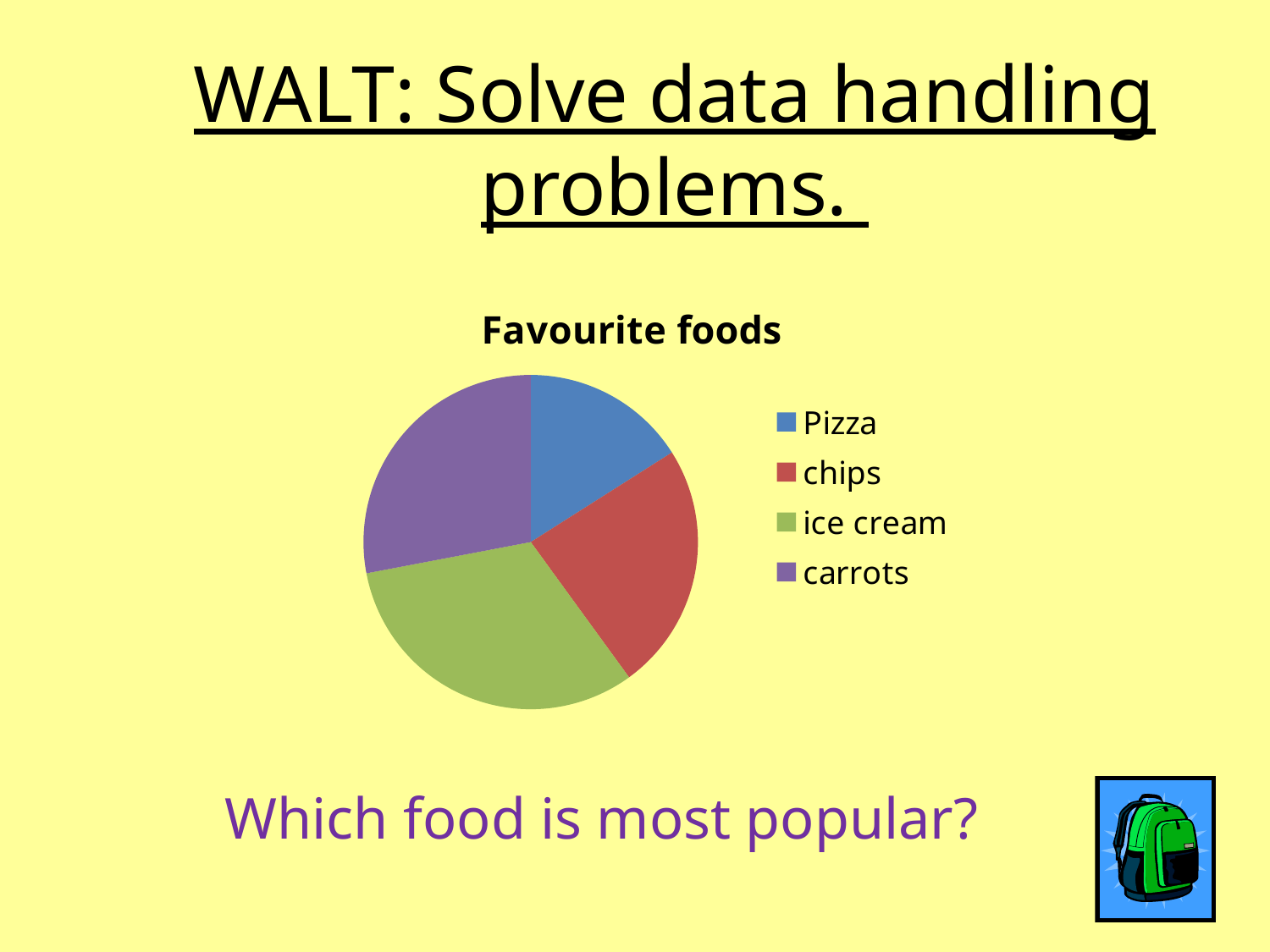
How many entries does the legend list? 4 What colour is the ice cream slice? green What kind of chart is shown on the slide? pie chart Which slice is larger, Pizza or ice cream? ice cream How many categories does the pie chart show? 4 Which food has the largest slice of the pie? ice cream Which slice is larger, Pizza or carrots? carrots What is the title of the chart? Favourite foods Which slice is larger, Pizza or chips? chips Which food has the smallest slice of the pie? Pizza